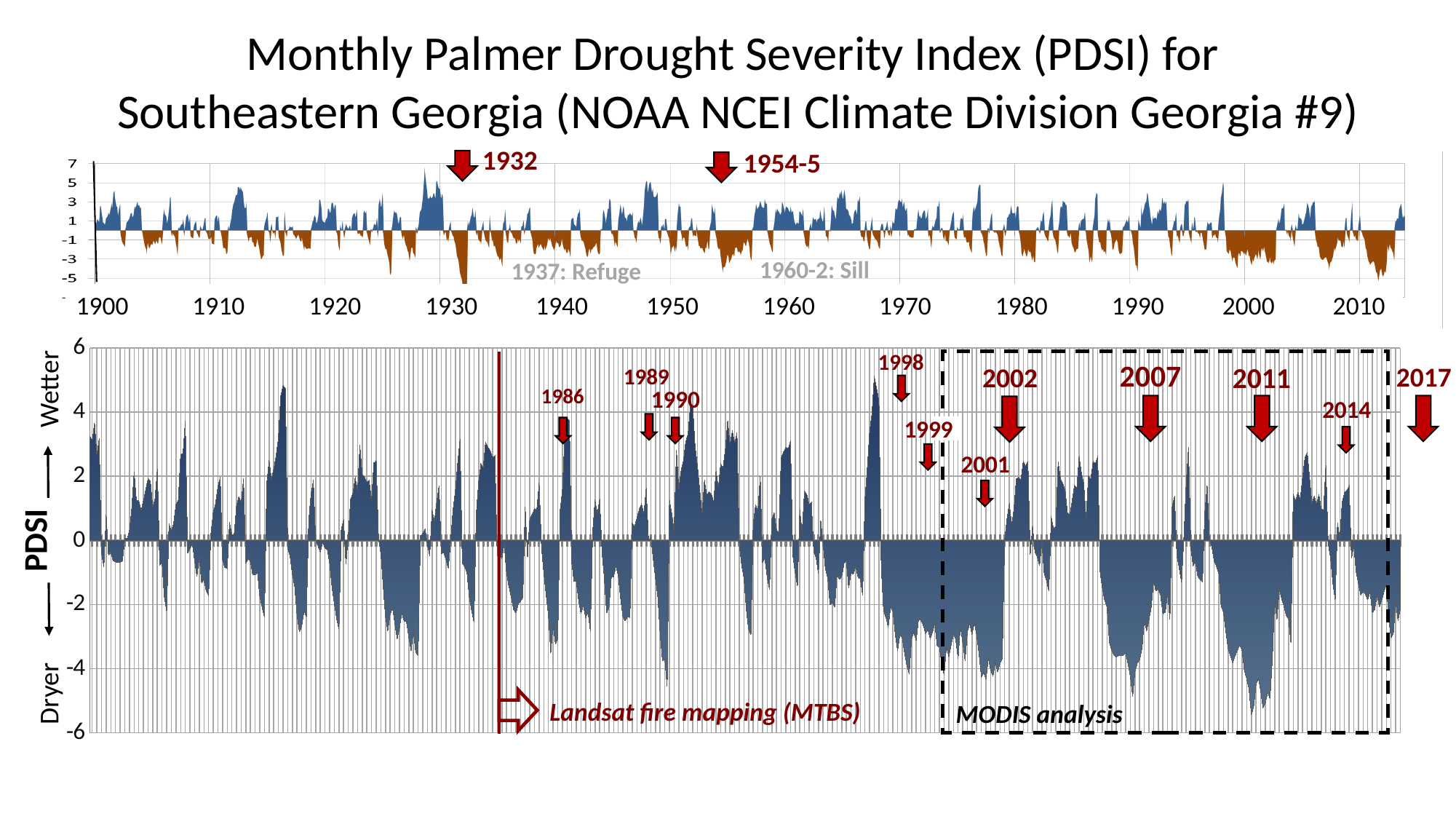
In the bottom chart, how many years are marked with red arrows? 11 In the bottom chart, is the PDSI peak marked 1998 greater or less than 4? greater In the top chart, which years are labelled next to the second red arrow? 1954-5 In the bottom chart, what is the lowest value shown on the PDSI axis? -6 In the top chart, is the PDSI value at the deepest dip around 1932 greater or less than -3? less In the bottom chart, is the lowest PDSI value near the 2011 arrow greater or less than -4? less In the top chart, what is the highest value shown on the y-axis? 7 What is the title of the slide's charts? Monthly Palmer Drought Severity Index (PDSI) for Southeastern Georgia (NOAA NCEI Climate Division Georgia #9) In the top chart, which year is labelled next to the first red arrow? 1932 In the top chart, what is the first year labelled on the x-axis? 1900